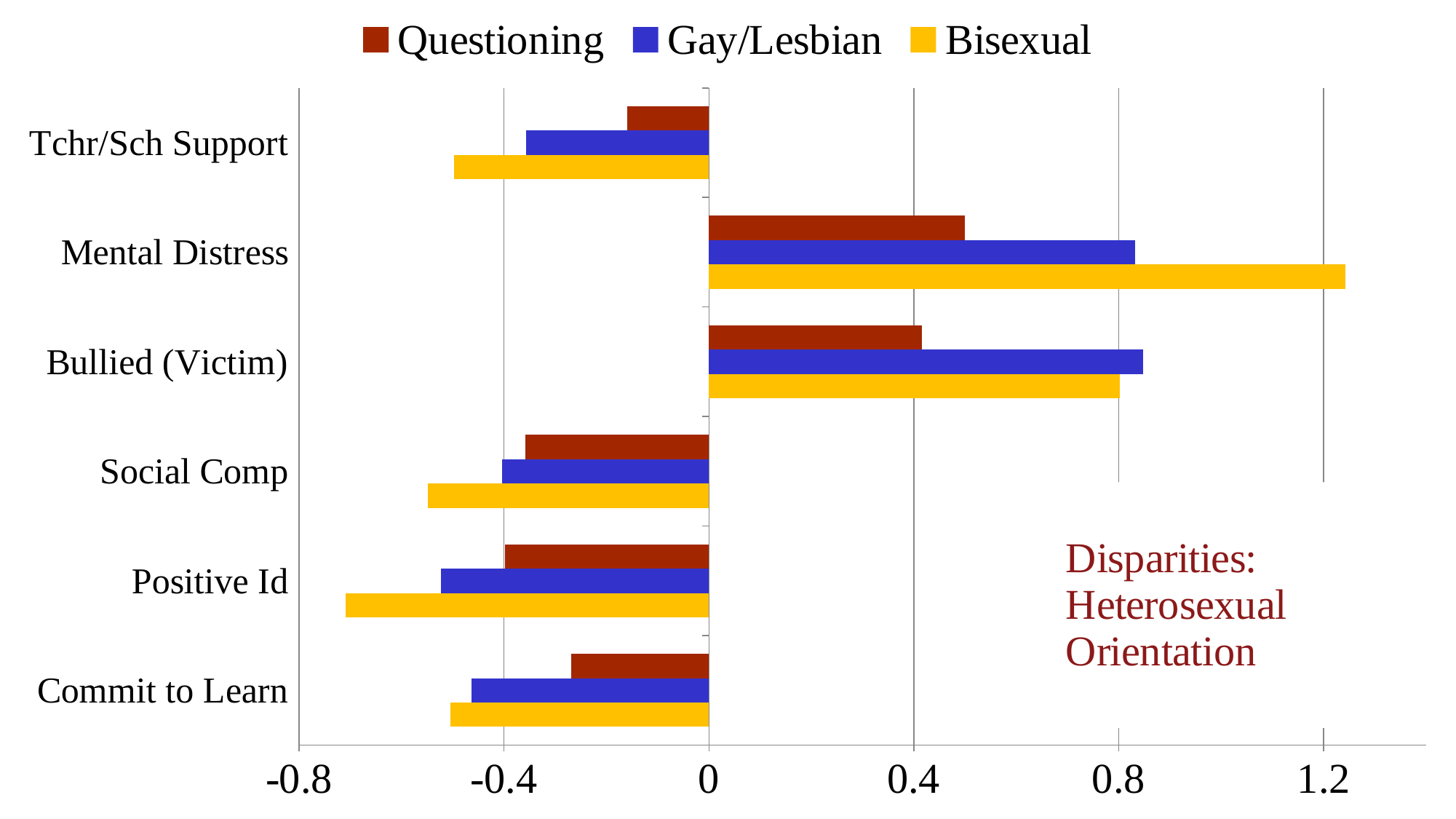
Which series has the highest value for Mental Distress? Bisexual Is the Questioning value for Mental Distress greater or less than 0.4? greater Is the Bisexual value for Mental Distress greater or less than 1.2? greater How many series does the chart's legend list? 3 Which series has the lowest (most negative) value for Positive Id? Bisexual How many categories are shown on the vertical axis of the chart? 6 For Mental Distress, which is larger: the Gay/Lesbian value or the Questioning value? Gay/Lesbian Is the Questioning value for Tchr/Sch Support greater or less than -0.4? greater For which category is the Bisexual bar the longest? Mental Distress What colour represents the Bisexual series in the chart? Yellow What kind of chart is shown on the slide? Bar chart